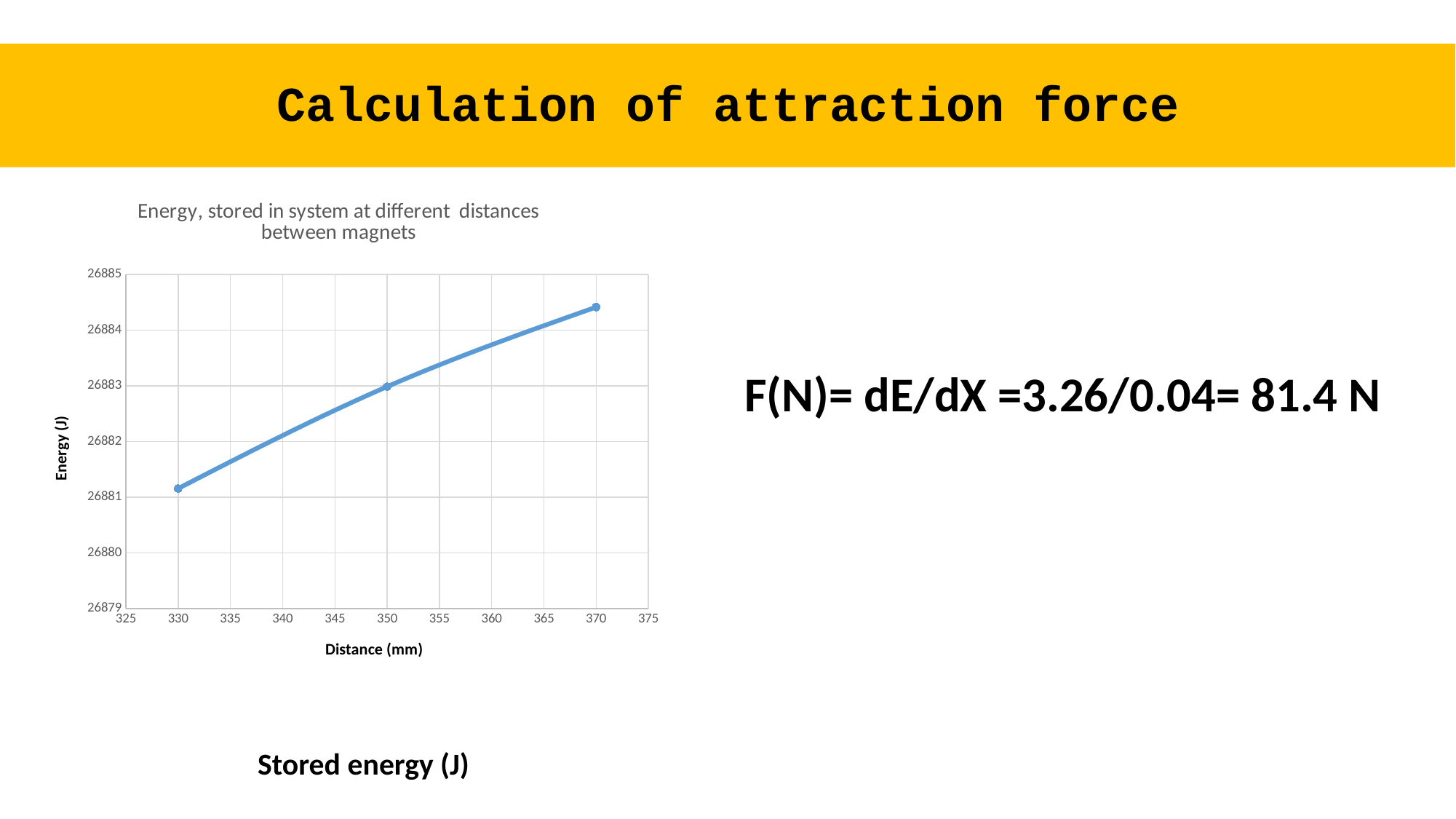
At which distance is the stored energy lowest? 330 Which has the larger stored energy: the point at 330 mm or the point at 370 mm? 370 mm What is the label of the x axis of the chart? Distance (mm) At which distance is the stored energy highest? 370 How many data points are plotted on the chart? 3 Is the energy value at a distance of 330 mm greater or less than 26881? greater Is the energy value at a distance of 350 mm greater or less than 26882? greater Is the energy value at a distance of 370 mm greater or less than 26884? greater What is the title of the chart? Energy, stored in system at different distances between magnets Does the stored energy rise or fall as the distance between magnets increases? rises What kind of chart is shown on the slide? line chart